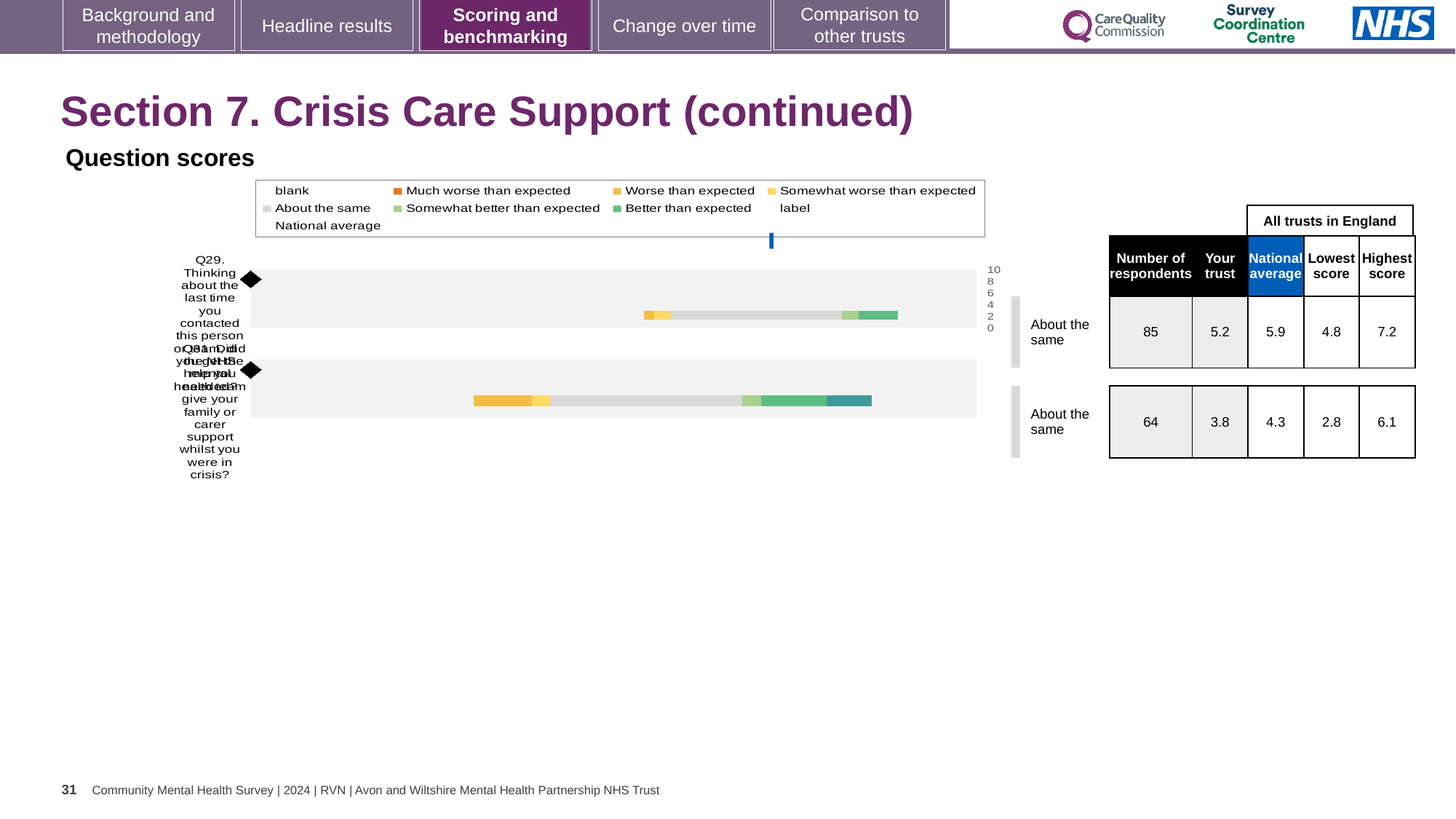
What kind of chart is shown under 'Question scores'? bar chart Which question numbers are plotted in the chart? Q29 and Q31 What colour does the legend use for 'Much worse than expected'? orange In the table beside the chart, what is the national average for Q29? 5.9 In the table beside the chart, what is the national average for Q31? 4.3 In the table beside the chart, how many respondents answered Q29? 85 How many questions (bars) are plotted in the chart? 2 In the table beside the chart, how many respondents answered Q31? 64 Which question has the higher 'Your trust' score in the table, Q29 or Q31? Q29 What is the difference between the highest score (7.2) and the lowest score (4.8) for Q29 in the table? 2.4 In the table beside the chart, what is the 'Your trust' score for Q31? 3.8 In the table beside the chart, what is the 'Your trust' score for Q29? 5.2